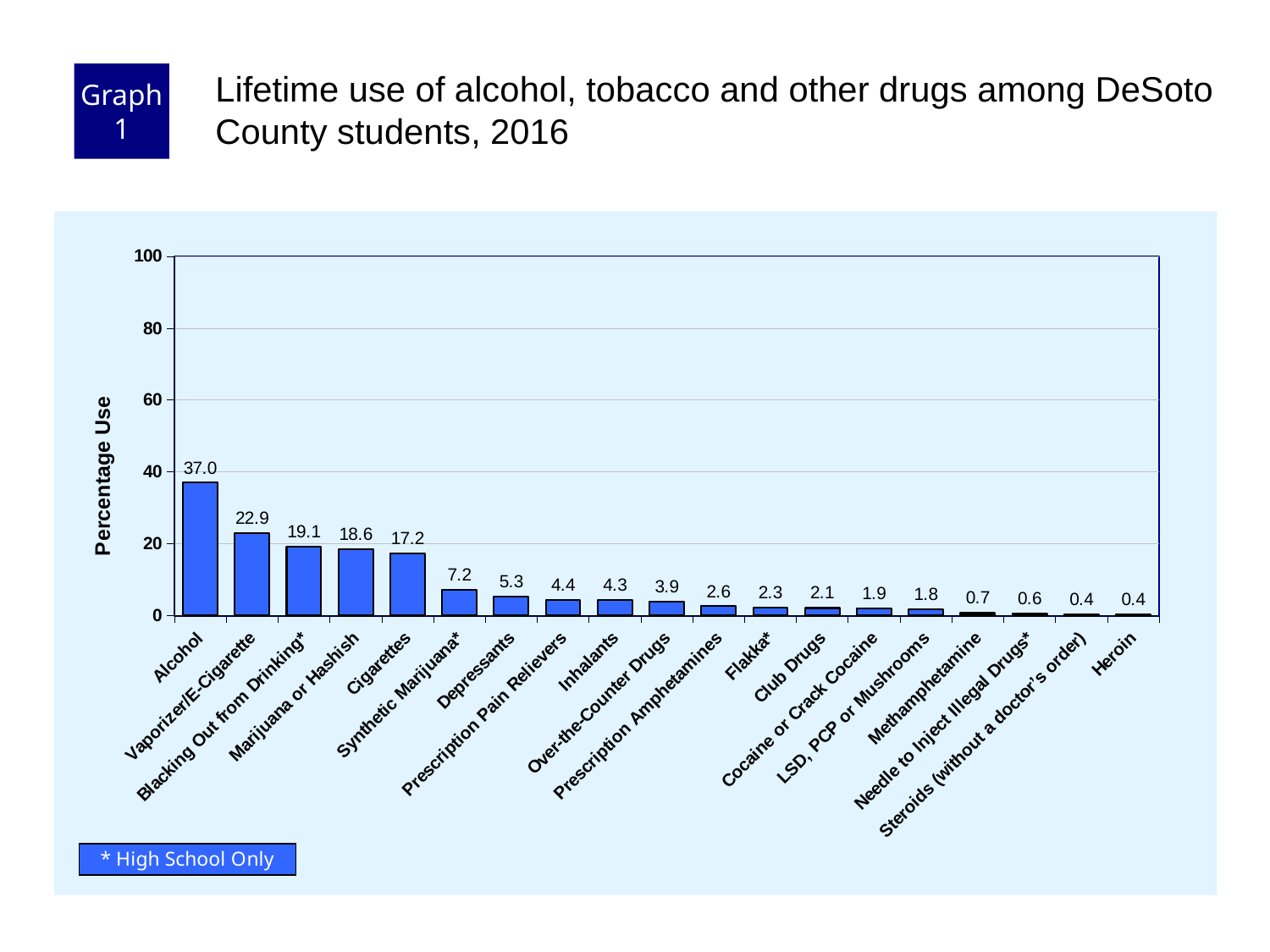
What does the asterisk (*) after some category names indicate? High School Only What is the percentage use for Vaporizer/E-Cigarette? 22.9 What is the percentage use for Synthetic Marijuana*? 7.2 Is the value for Vaporizer/E-Cigarette greater or less than 20? greater What is the percentage use for Alcohol? 37.0 Which has a higher percentage use, Depressants or Inhalants? Depressants How many categories are shown on the x axis? 19 What is the percentage use for Methamphetamine? 0.7 What kind of chart is shown on the slide? Bar chart What is the difference in percentage use between Blacking Out from Drinking* and Marijuana or Hashish? 0.5 Which category has the highest percentage use? Alcohol What is the difference in percentage use between Alcohol and Cigarettes? 19.8